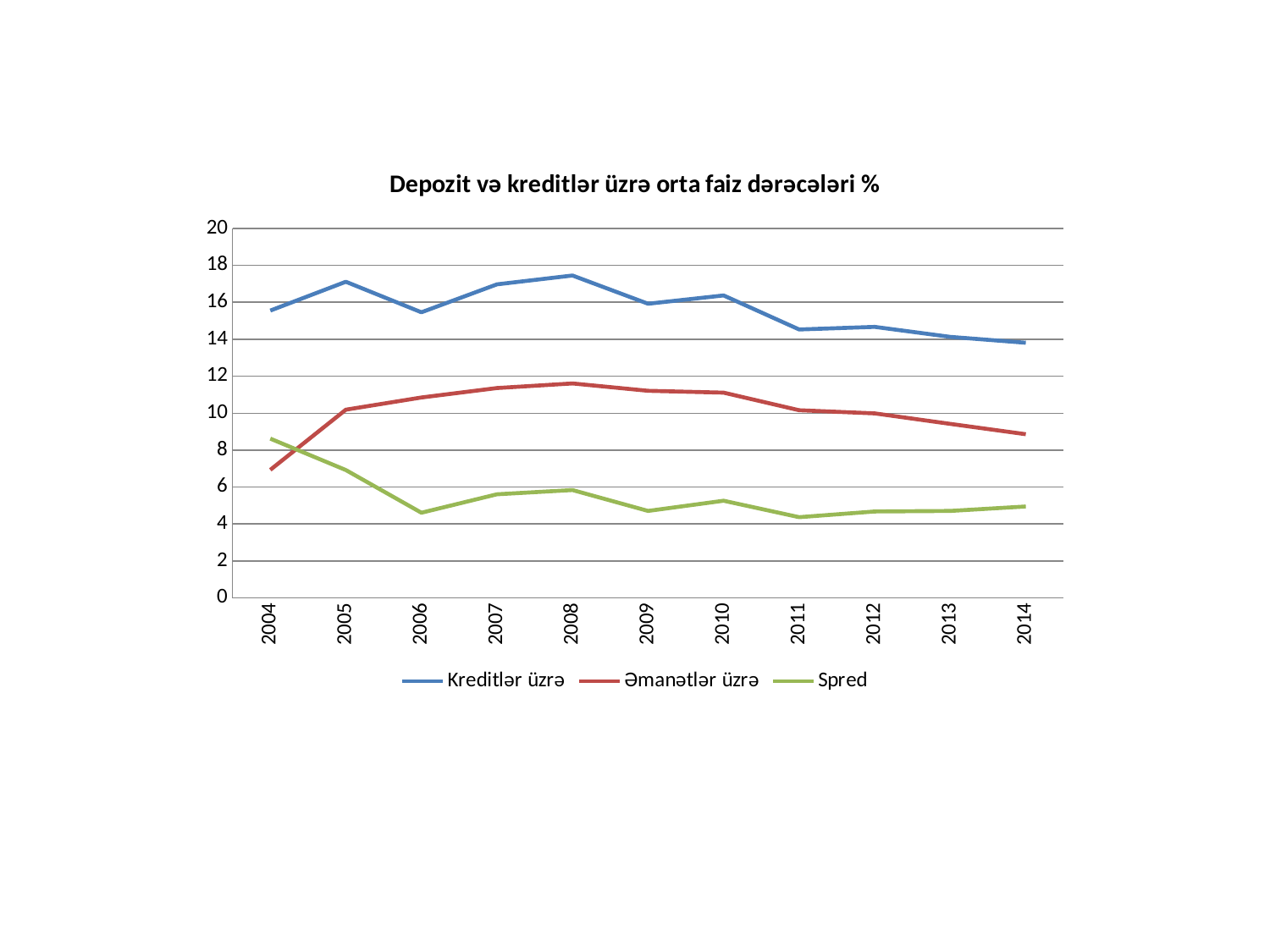
How many series does the legend list? 3 In which year is the Spred value highest? 2004 Which series is drawn in green? Spred In 2005, which is larger: Əmanətlər üzrə or Spred? Əmanətlər üzrə Does the Kreditlər üzrə line rise or fall from 2010 to 2014? fall Is the Əmanətlər üzrə value for 2004 greater or less than 8? less What is the title of the chart? Depozit və kreditlər üzrə orta faiz dərəcələri % How many years are shown on the x axis? 11 In which year is the Əmanətlər üzrə value lowest? 2004 Is the Kreditlər üzrə value for 2008 greater or less than 16? greater Is the Spred value for 2006 greater or less than 6? less What kind of chart is shown on the slide? line chart